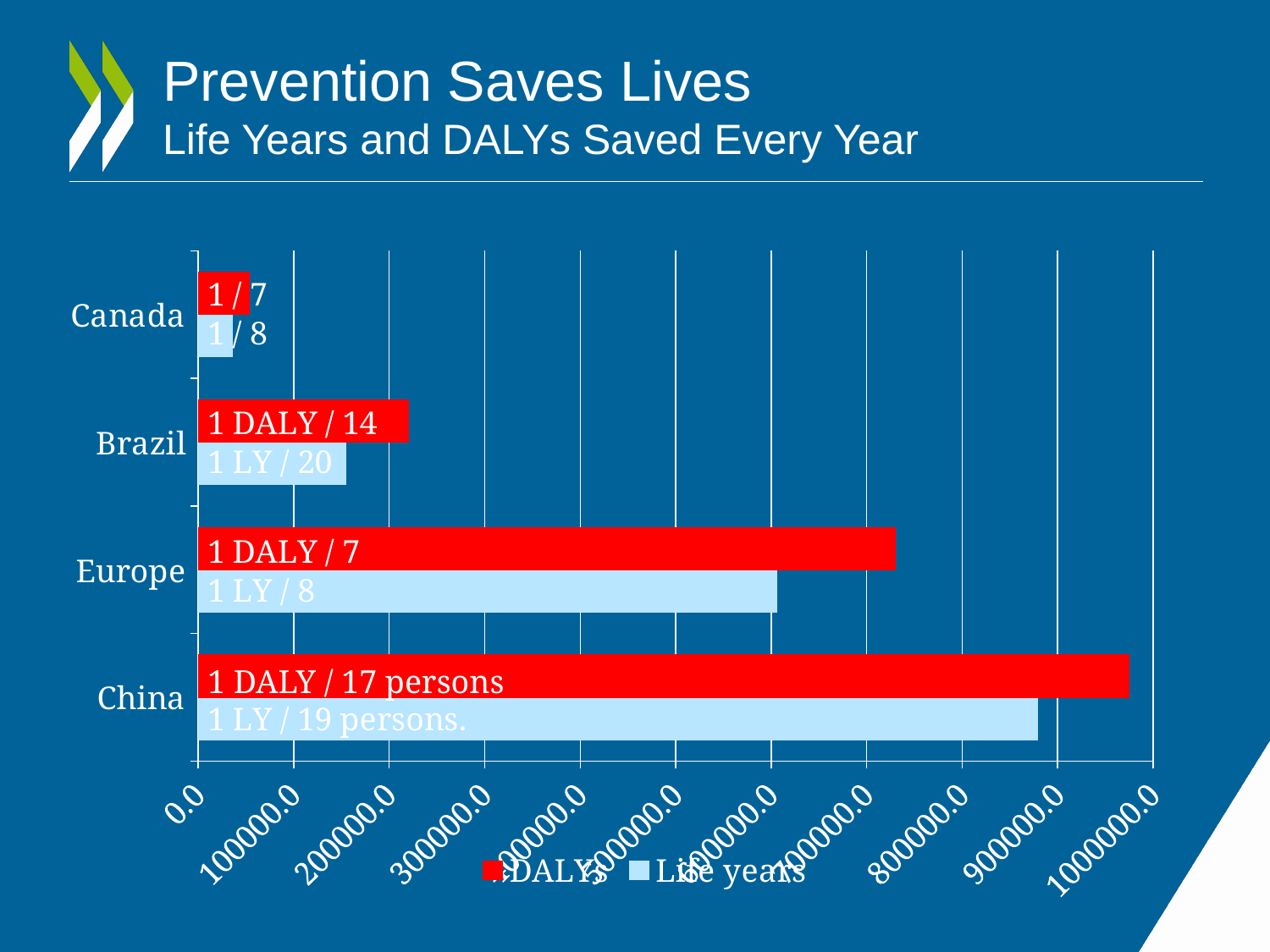
What kind of chart is shown on the slide? bar chart For China, which is larger, the DALYs bar or the Life years bar? DALYs Is the DALYs value for Brazil greater or less than 300000.0? less Is the Life years value for Europe greater or less than 500000.0? greater What are the two entries in the chart legend? DALYs and Life years Is the Life years value for Canada greater or less than 100000.0? less Which category has the shortest Life years bar? Canada Which has the larger DALYs value, Europe or Brazil? Europe Which category has the longest DALYs bar? China How many categories (regions) are shown on the chart? 4 How many series does the legend list? 2